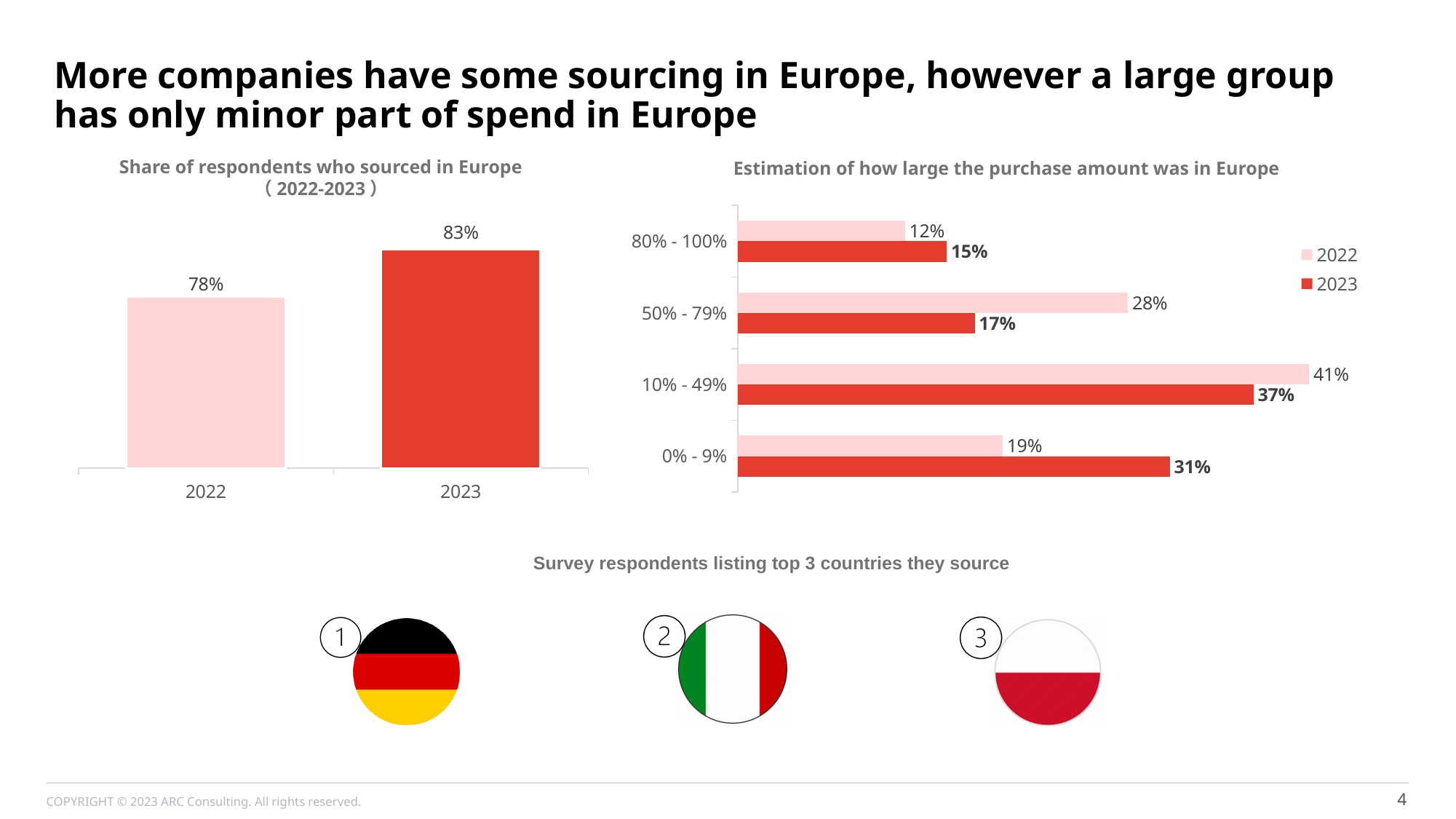
In the 'Estimation of how large the purchase amount was in Europe' chart, what is the 2023 value for 0% - 9%? 31% In the 'Estimation of how large the purchase amount was in Europe' chart, which category has the highest 2022 value? 10% - 49% In the 'Share of respondents who sourced in Europe' chart, what is the value for 2022? 78% In the 'Estimation of how large the purchase amount was in Europe' chart, what is the difference between the 2022 and 2023 values for 10% - 49%? 4% How many series does the legend of the 'Estimation of how large the purchase amount was in Europe' chart list? 2 In the 'Estimation of how large the purchase amount was in Europe' chart, which is larger for 50% - 79%: the 2022 value or the 2023 value? 2022 In the 'Share of respondents who sourced in Europe' chart, what is the difference between the 2023 and 2022 values? 5% In the 'Share of respondents who sourced in Europe' chart, do the values rise or fall from 2022 to 2023? rise In the 'Share of respondents who sourced in Europe' chart, what is the value for 2023? 83% In the 'Estimation of how large the purchase amount was in Europe' chart, what is the 2022 value for 50% - 79%? 28% In the 'Estimation of how large the purchase amount was in Europe' chart, which category has the lowest 2023 value? 80% - 100% What kind of chart is 'Share of respondents who sourced in Europe'? bar chart